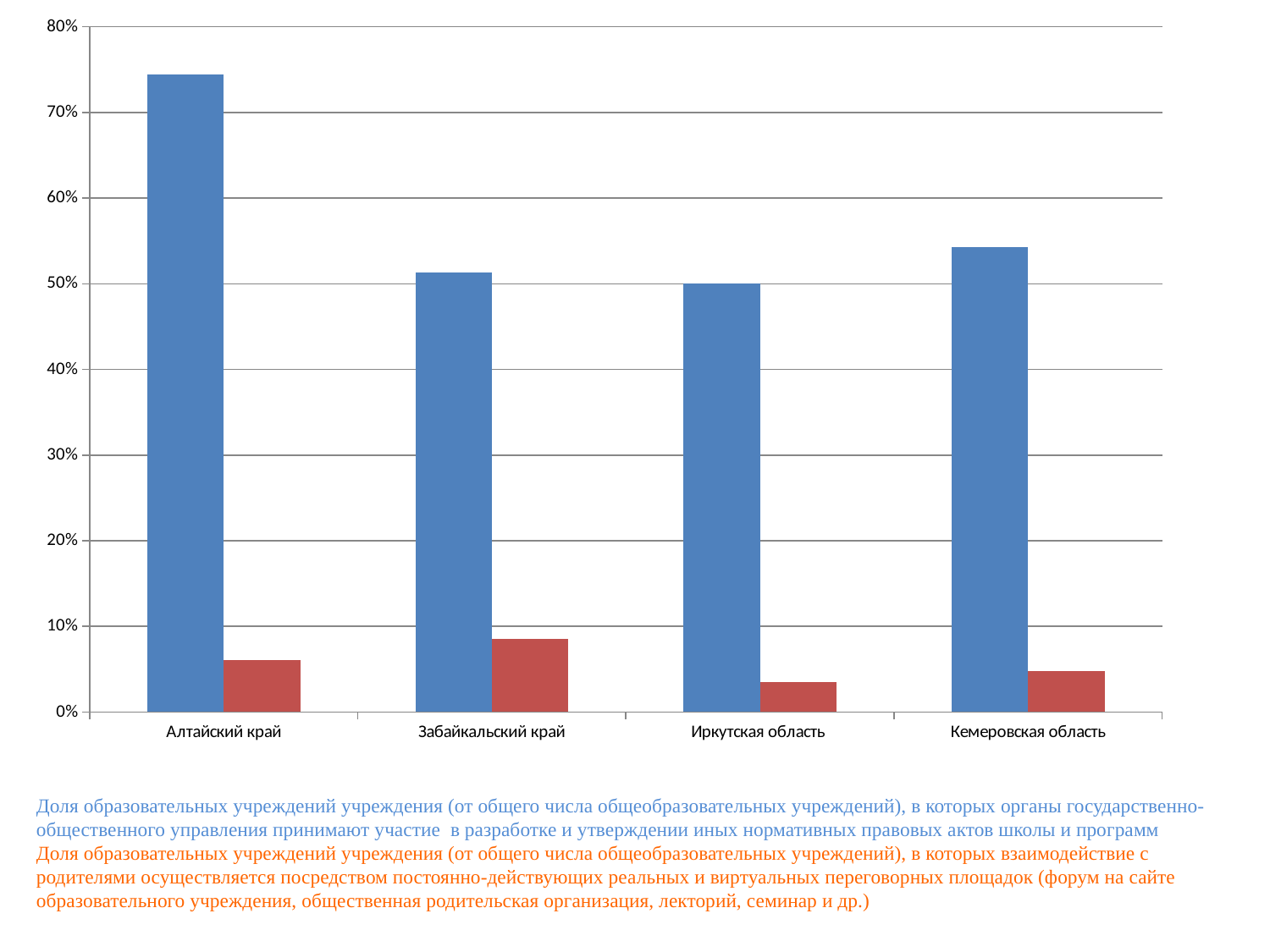
How many bars are plotted for each region? 2 Which region has the lowest red bar? Иркутская область How many regions (categories) are shown on the x axis? 4 Is the blue bar for Кемеровская область greater or less than 50%? greater Which region has the highest red bar? Забайкальский край What kind of chart is shown on the slide? Bar chart Which colour is used for the bars representing the share of institutions where interaction with parents takes place through permanent real and virtual discussion platforms? Red Which region has the lowest blue bar? Иркутская область Which is larger, the blue bar for Кемеровская область or the blue bar for Забайкальский край? Кемеровская область Is the blue bar for Алтайский край greater or less than 70%? greater Is the red bar for Забайкальский край greater or less than 10%? less Which region has the highest blue bar? Алтайский край